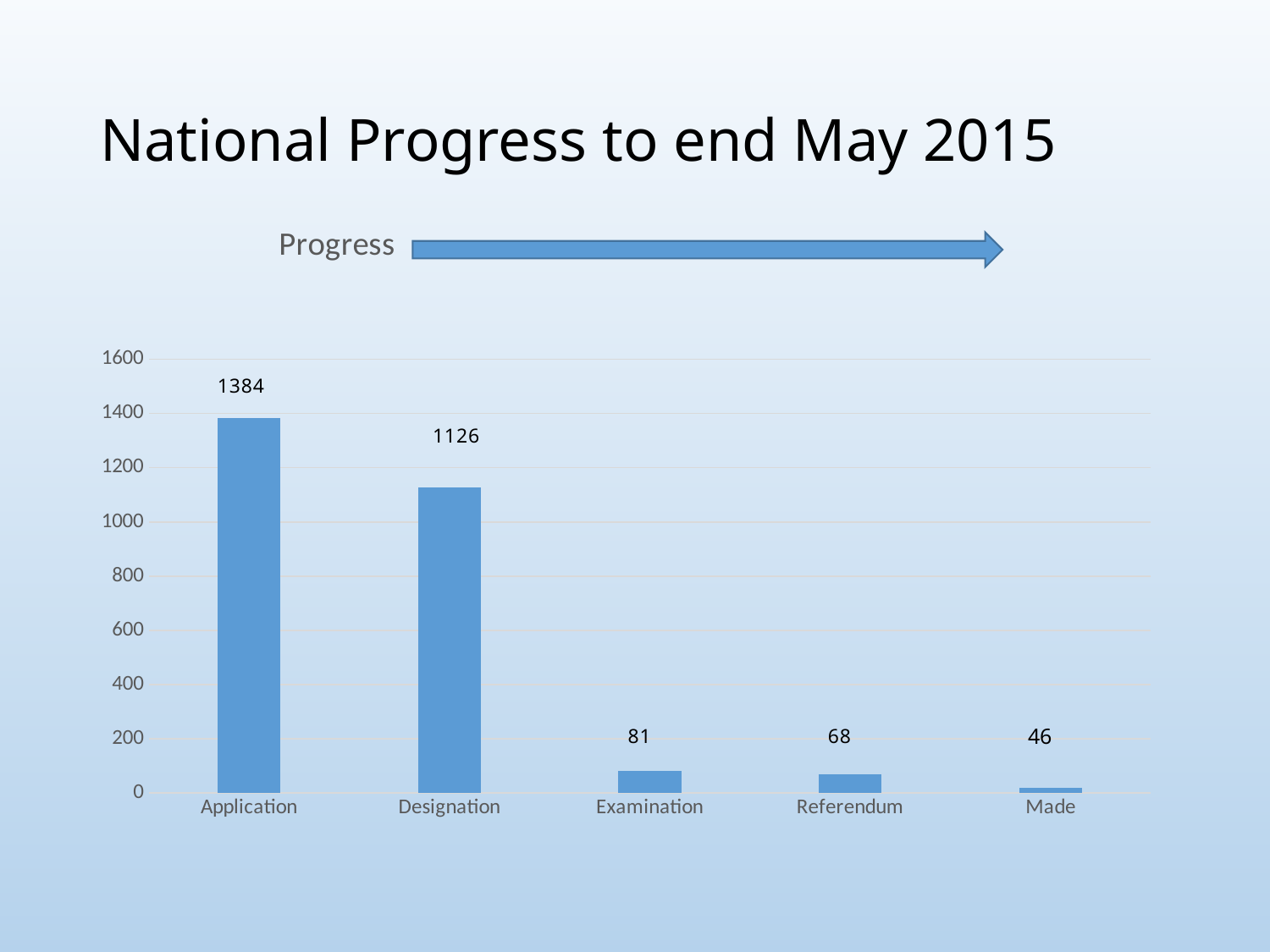
What is the value for Examination? 81 What is the value for Referendum? 68 Which is larger, the value for Examination or the value for Referendum? Examination Is the value for Designation greater or less than 1000? greater What kind of chart is shown on the slide? bar chart Which category has the highest value? Application What is the value for Made? 46 Which category has the lowest value? Made What is the value for Designation? 1126 What is the difference between the values for Application and Designation? 258 How many categories are shown on the x axis? 5 What is the value for Application? 1384